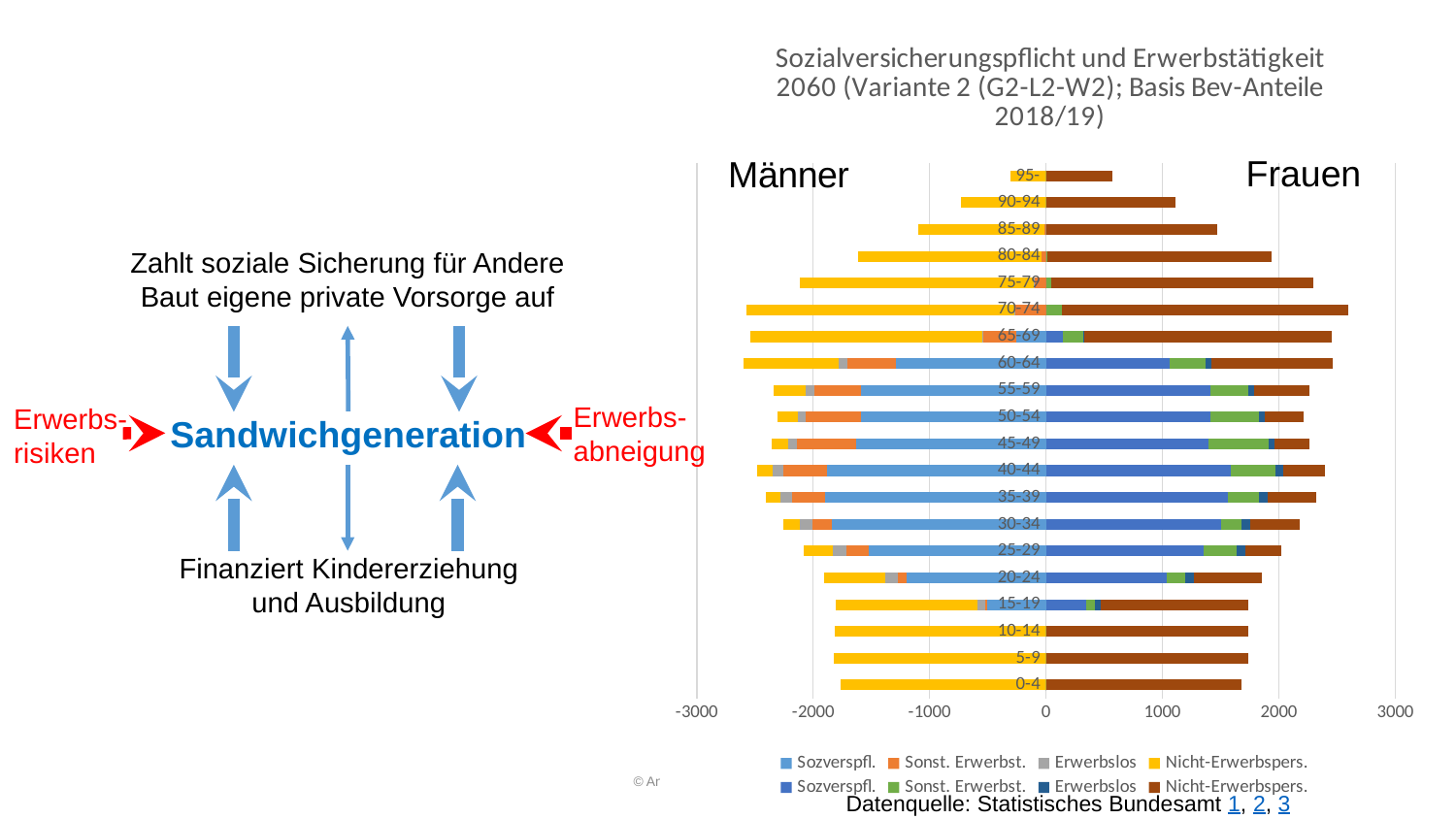
Which age group has the shortest bar on the Frauen side of the chart? 95- How many series does the chart legend list? 8 Is the total bar length for Frauen aged 70-74 greater or less than 2000? greater Is the total bar length for Frauen aged 0-4 greater or less than 2000? less Which age group has the longest bar on the Frauen side of the chart? 70-74 On the Frauen side, which bar is longer: 90-94 or 95-? 90-94 What kind of chart is shown on the slide? bar chart Is the total bar length for Frauen aged 95- greater or less than 1000? less What is the title of the chart? Sozialversicherungspflicht und Erwerbstätigkeit 2060 (Variante 2 (G2-L2-W2); Basis Bev-Anteile 2018/19) Which age group has the shortest bar on the Männer side of the chart? 95- How many age groups are shown on the vertical axis of the chart? 20 Which group is plotted on the left side of the chart and which on the right? Männer on the left, Frauen on the right